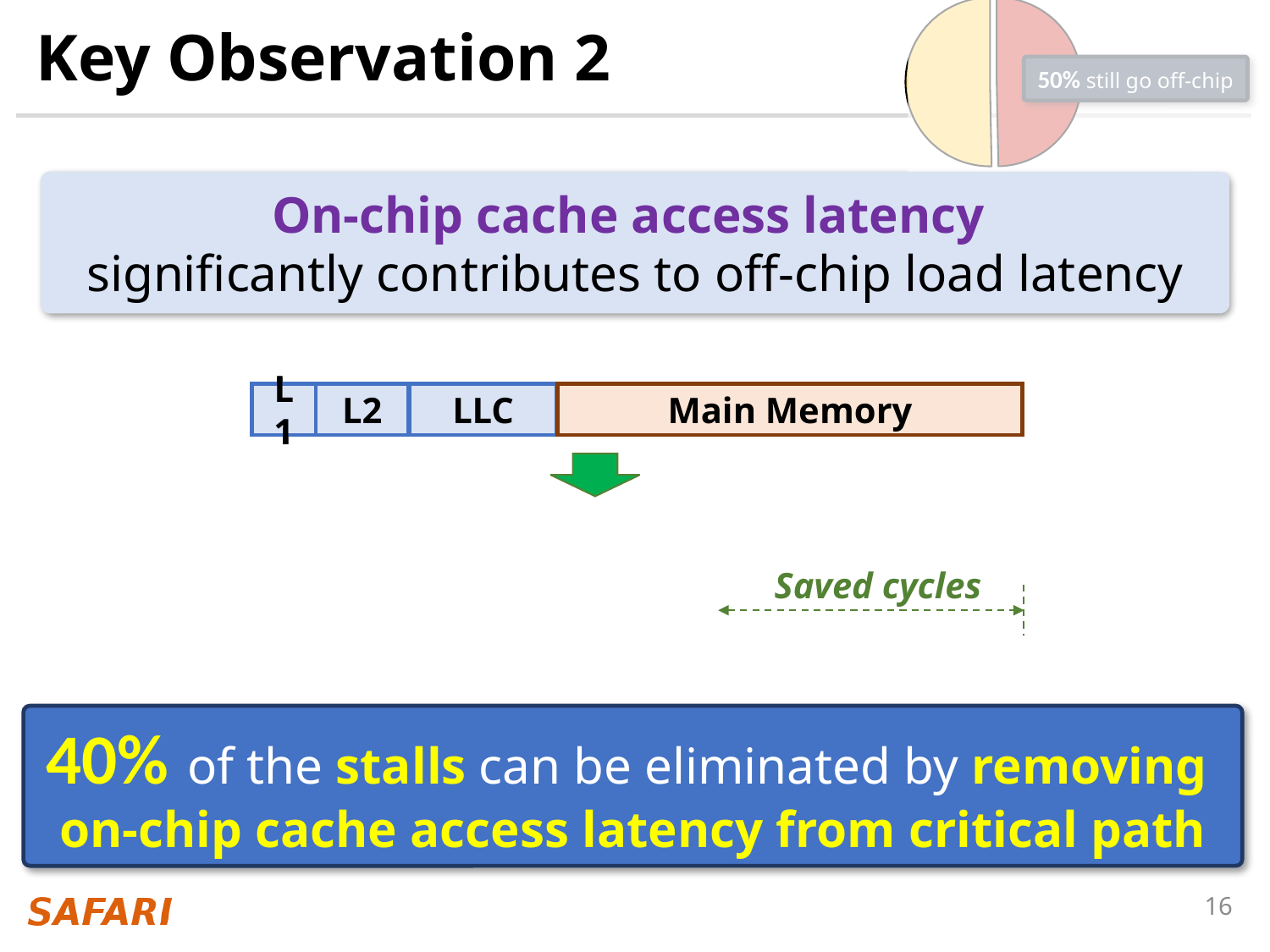
How many slices does the pie chart at the top right of the slide have? 2 Is the share labelled 'still go off-chip' in the pie chart greater or less than 25%? greater What kind of chart is shown in the top right corner of the slide? pie chart In the pie chart at the top right, what share of loads is labelled as still going off-chip? 50% What does the label attached to the pie chart at the top right say? 50% still go off-chip